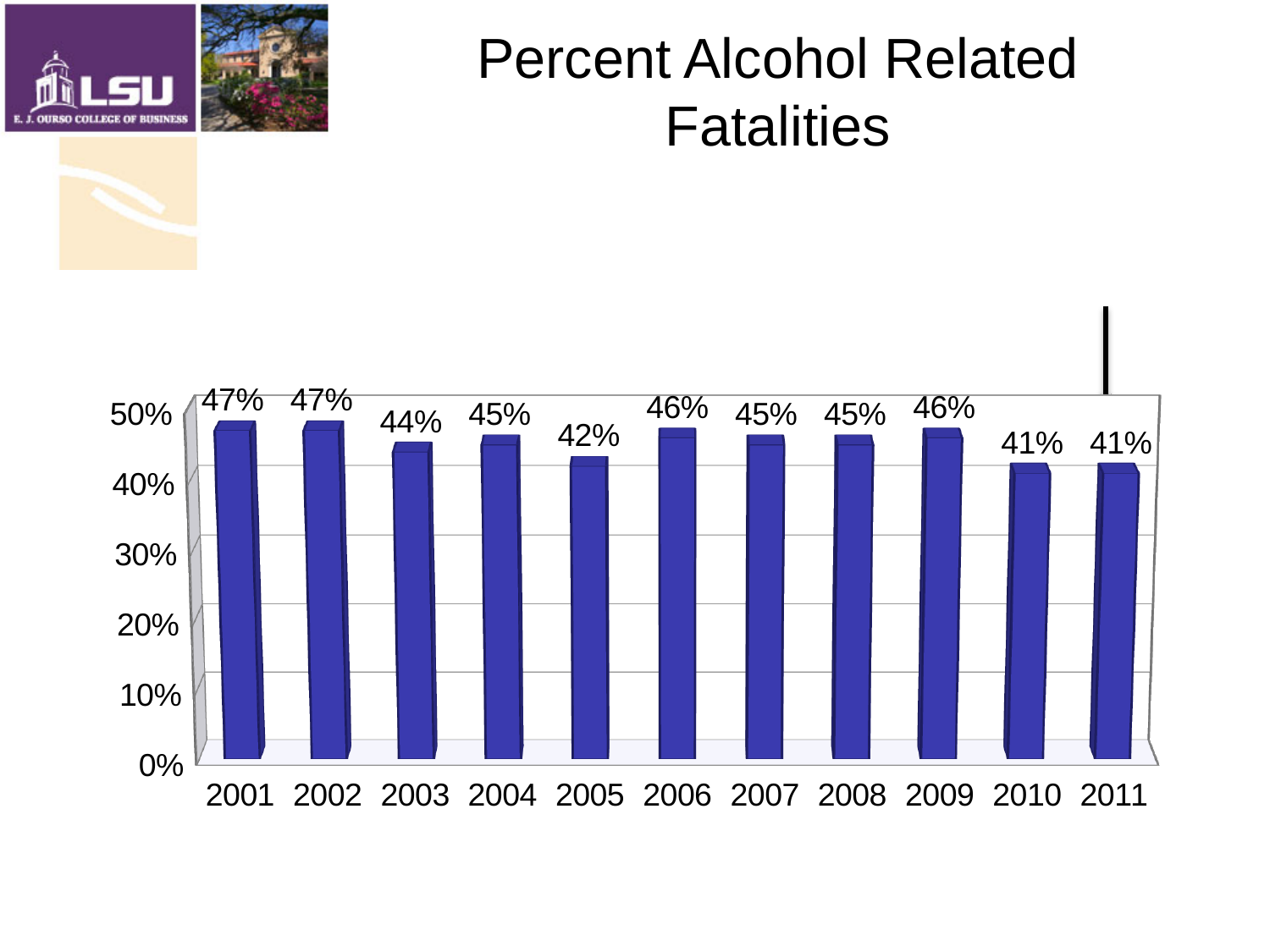
What is the highest value shown in the chart? 47% What kind of chart is shown on the slide? Bar chart What is the value for 2009? 46% What is the difference between the values for 2001 and 2011? 6% What is the value for 2005? 42% What is the title of the chart? Percent Alcohol Related Fatalities What is the value for 2011? 41% What is the value for 2003? 44% What is the difference between the values for 2006 and 2005? 4% What is the lowest value shown in the chart? 41% Which is larger, the value for 2002 or the value for 2010? 2002 How many years are shown on the x axis? 11